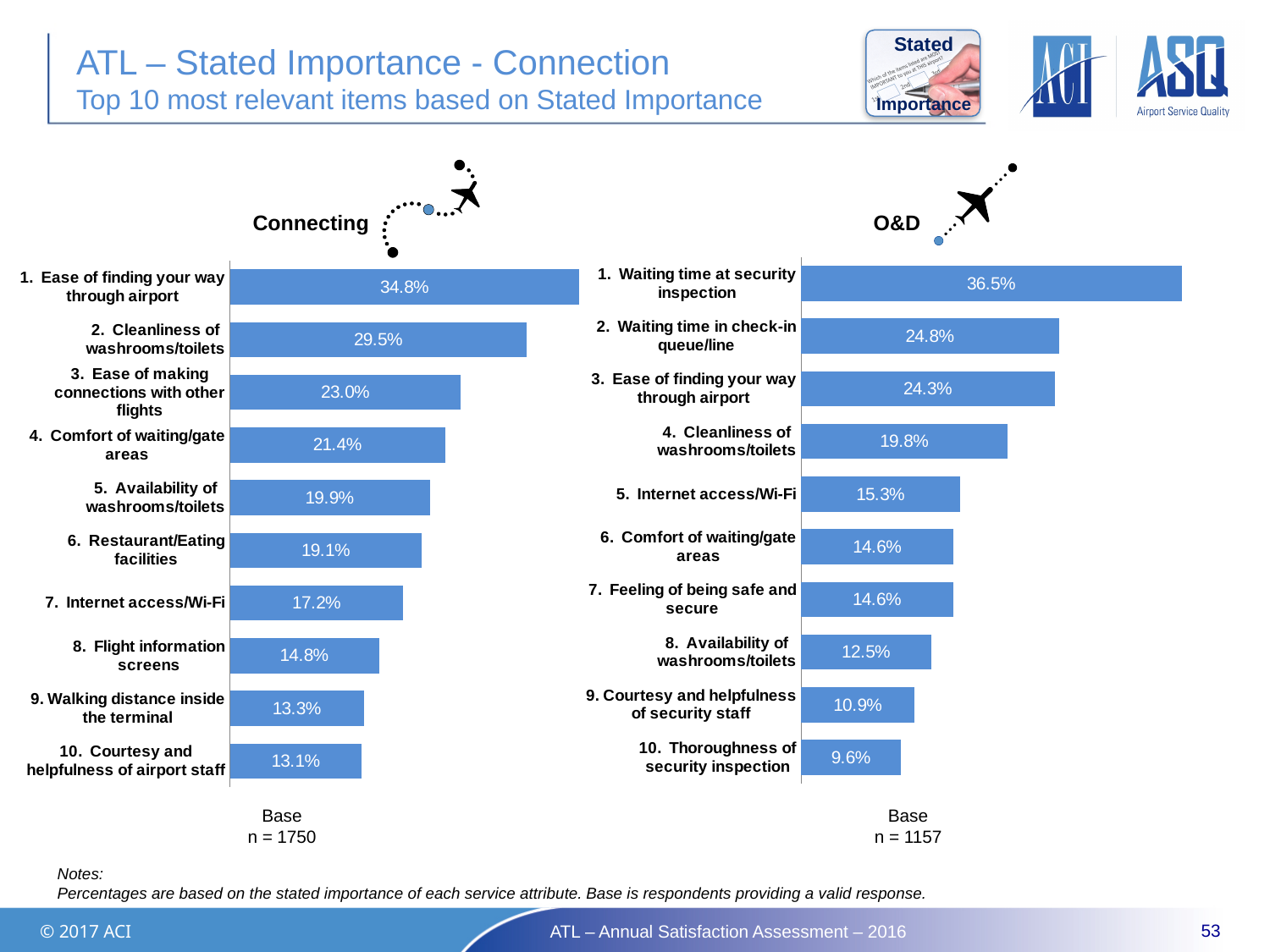
What is the base (n) for the O&D chart? n = 1157 In the O&D chart, what is the value for Internet access/Wi-Fi? 15.3% In the Connecting chart, what is the value for Ease of finding your way through airport? 34.8% In the Connecting chart, which item has the lowest value? Courtesy and helpfulness of airport staff In the O&D chart, which item has the highest value? Waiting time at security inspection Which is larger: Internet access/Wi-Fi in the Connecting chart or Internet access/Wi-Fi in the O&D chart? Connecting In the O&D chart, what is the difference between Waiting time at security inspection and Thoroughness of security inspection? 26.9% What type of chart is the O&D chart? Bar chart In the Connecting chart, do the values rise or fall from the top item to the bottom item? Fall In the O&D chart, what is the value for Waiting time at security inspection? 36.5% In the Connecting chart, what is the difference between Cleanliness of washrooms/toilets and Availability of washrooms/toilets? 9.6% How many items are shown in the Connecting chart? 10